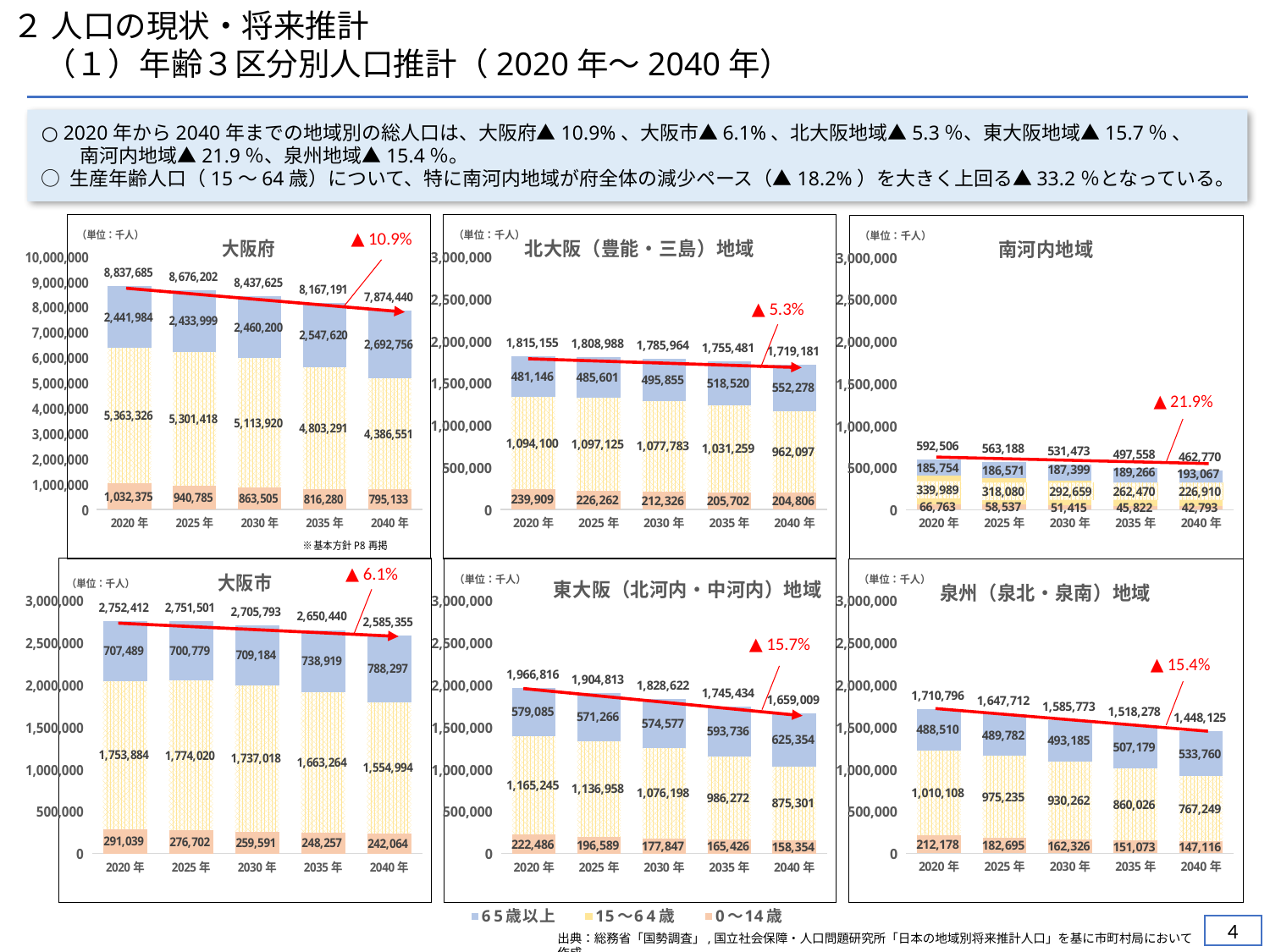
What kind of chart is the 南河内地域 chart? Stacked bar chart In the 南河内地域 chart, what is the value of the 0～14歳 segment for 2020年? 66,763 How many series does the legend at the bottom of the slide list? 3 In the 大阪市 chart, what is the value of the 15～64歳 segment for 2040年? 1,554,994 In the 大阪市 chart, does the total population rise or fall from 2020年 to 2040年? Fall In the 泉州（泉北・泉南）地域 chart, what is the difference between the total population in 2020年 and in 2040年? 262,671 In the 東大阪（北河内・中河内）地域 chart, which year has the lowest total population? 2040年 How many years are plotted on the x axis of the 大阪市 chart? 5 In the 大阪府 chart, what is the total population labeled for 2020年? 8,837,685 In the 大阪府 chart, which is larger: the 65歳以上 value for 2020年 or for 2040年? 2040年 In the 南河内地域 chart, what is the total of the stacked bar for 2040年? 462,770 In the 北大阪（豊能・三島）地域 chart, which year has the highest 65歳以上 value? 2040年